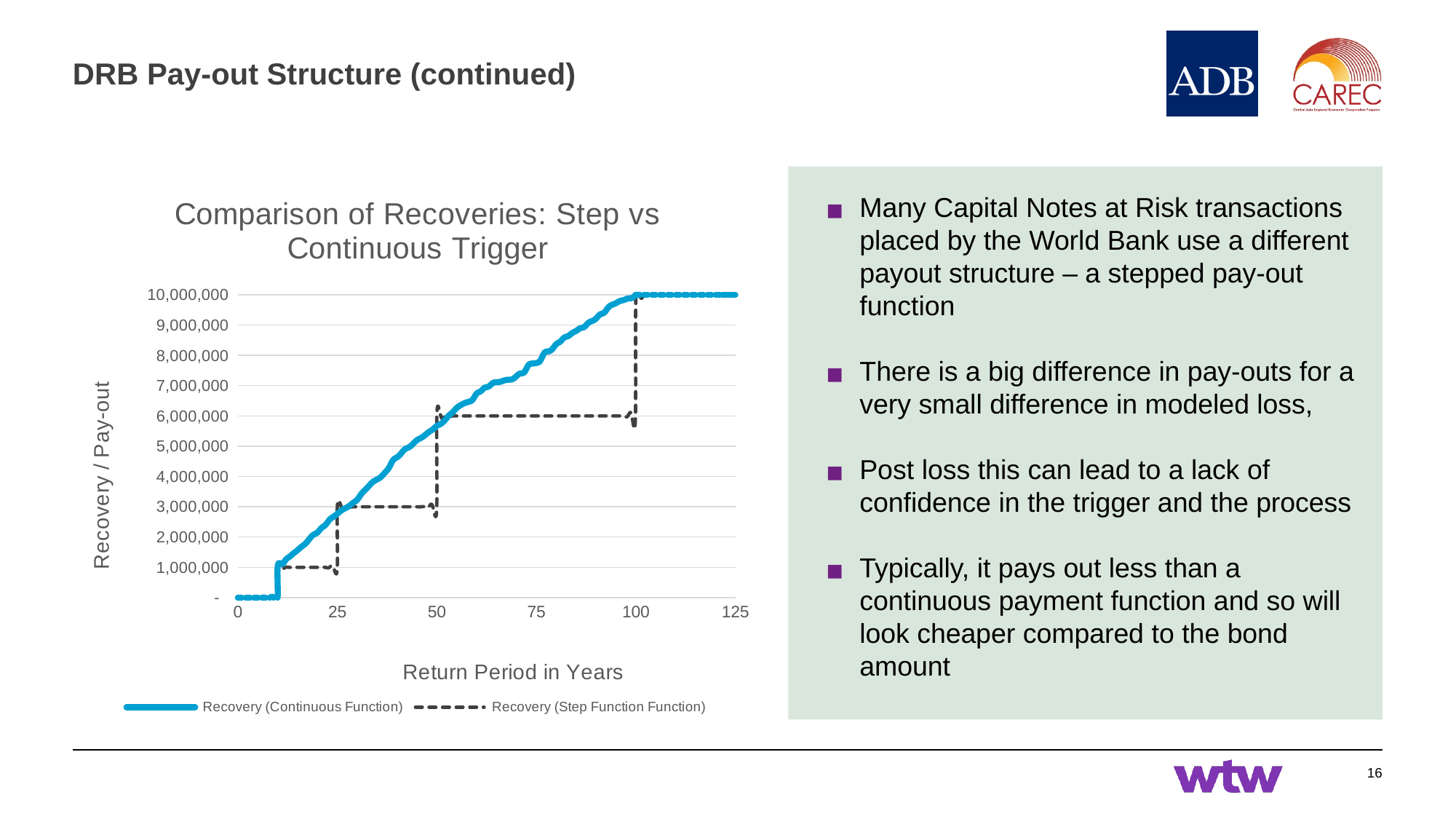
At what value do both series level off for return periods beyond 100 years? 10,000,000 What is the label of the x axis of the chart? Return Period in Years What is the title of the chart? Comparison of Recoveries: Step vs Continuous Trigger At what value does the Recovery (Step Function Function) series stay flat between return periods of 50 and 100 years? 6,000,000 What kind of chart is shown on the slide? Line chart Is the value of the Recovery (Continuous Function) series at a return period of 75 years greater or less than 7,000,000? greater Is the value of the Recovery (Step Function Function) series at a return period of 40 years greater or less than 5,000,000? less At what value does the Recovery (Step Function Function) series stay flat between return periods of 25 and 50 years? 3,000,000 Is the value of the Recovery (Continuous Function) series at a return period of 25 years greater or less than 4,000,000? less Do the recovery values rise or fall as the return period increases along the x axis? Rise How many series does the legend of the chart list? 2 Which series is drawn as a dashed line in the chart? Recovery (Step Function Function)